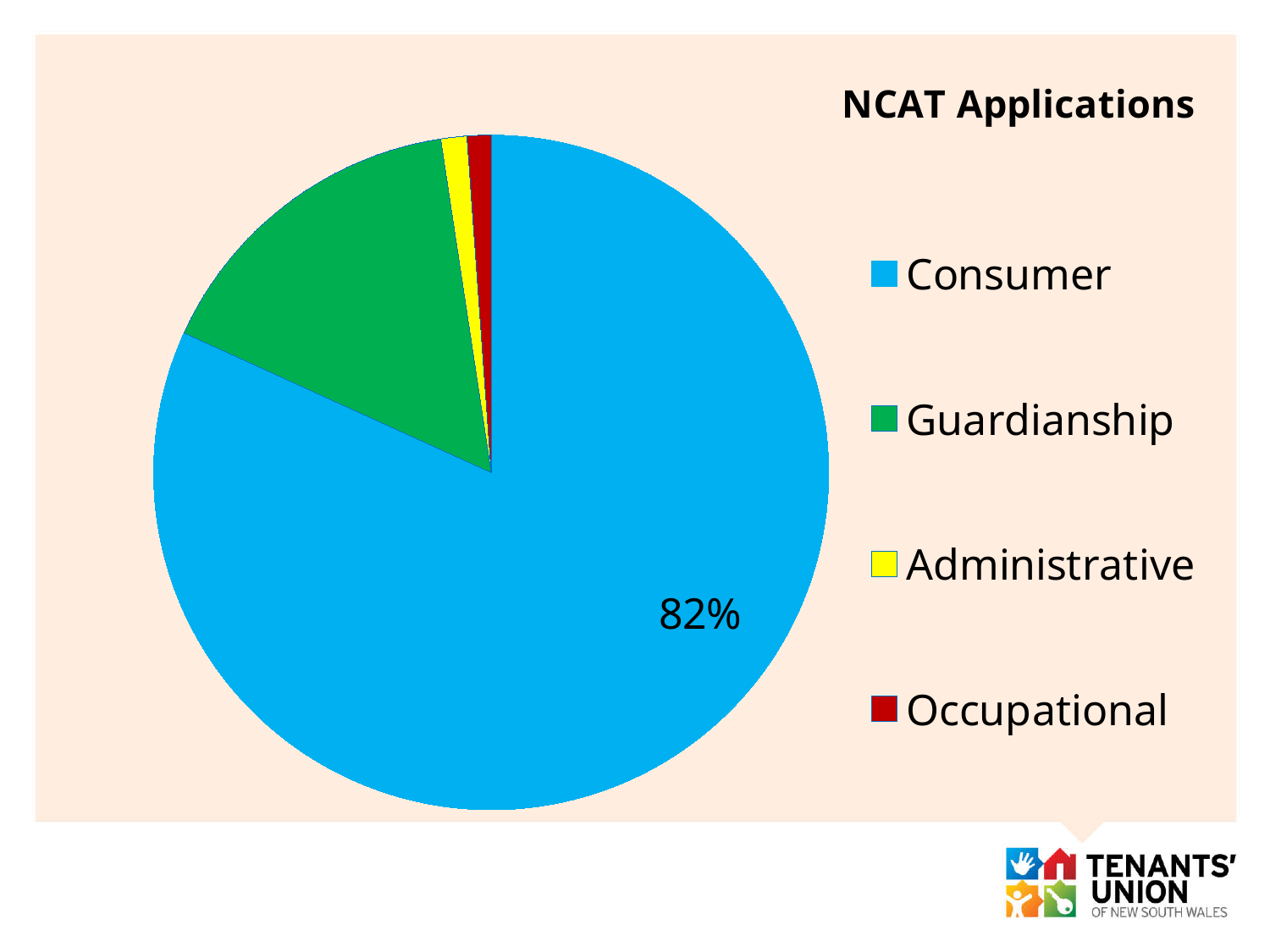
What is the title of the chart? NCAT Applications How many categories does the legend list? 4 Which colour represents Guardianship in the chart? green What share of NCAT Applications is Consumer? 82% Which category has the largest slice of the pie? Consumer Which is larger, the Administrative slice or the Occupational slice? Administrative Which is larger, the Guardianship slice or the Administrative slice? Guardianship Which category has the smallest slice of the pie? Occupational Which is larger, the Consumer slice or the Guardianship slice? Consumer Which category is the second largest slice of the pie? Guardianship What type of chart is shown on the slide? pie chart